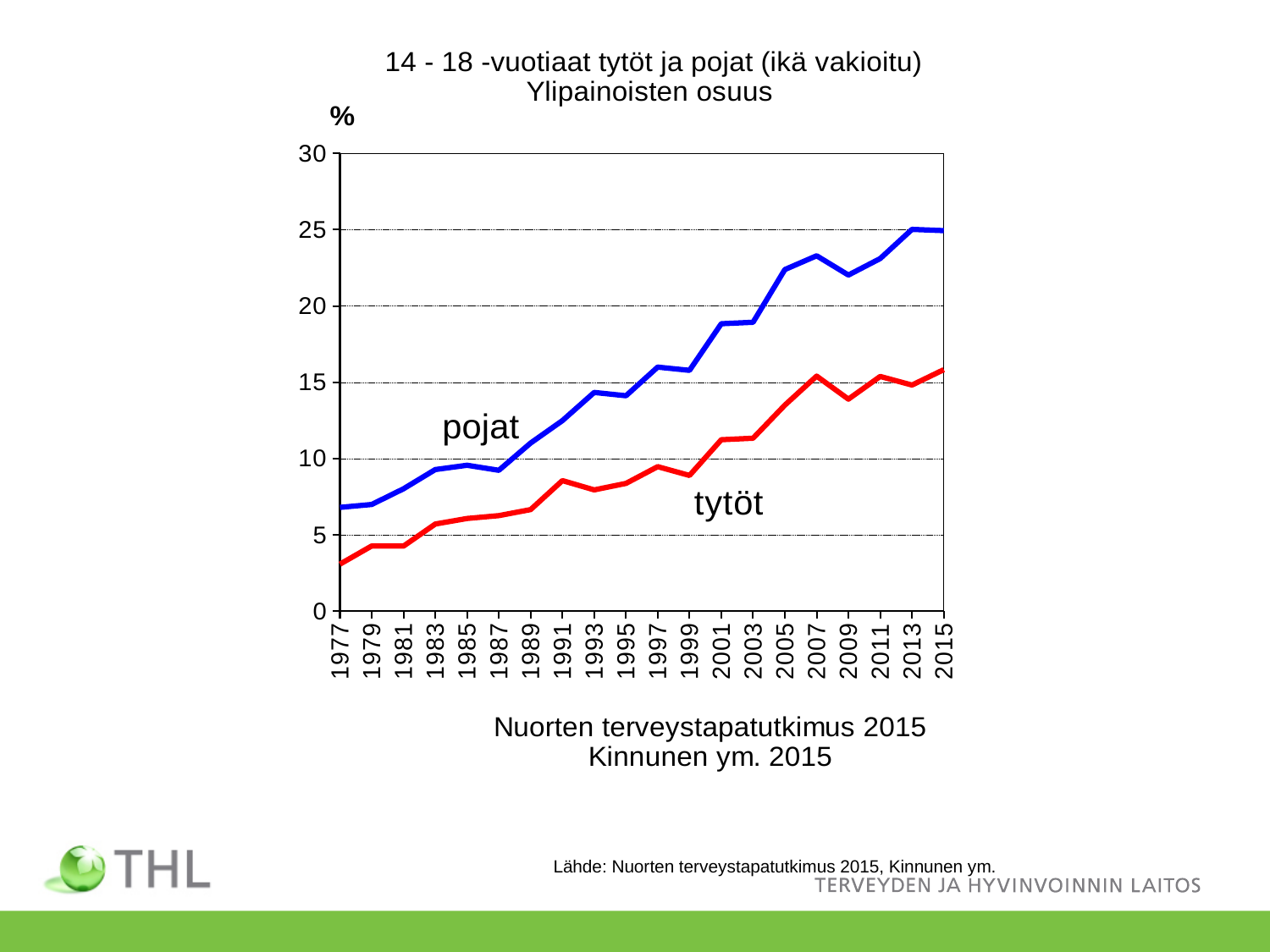
Is the value for pojat in 2015 greater or less than 20? greater In 2015, which series has the higher value, pojat or tytöt? pojat In which year is the tytöt series at its lowest value? 1977 What are the two series labelled on the chart? pojat and tytöt Does the pojat line generally rise or fall from 1977 to 2015? rise How many years are marked on the x axis of the chart? 20 How many series are plotted on the chart? 2 Is the value for tytöt in 1977 greater or less than 5? less What kind of chart is shown on the slide? line chart Is the value for tytöt in 2015 greater or less than 10? greater Does the tytöt line generally rise or fall from 1977 to 2015? rise